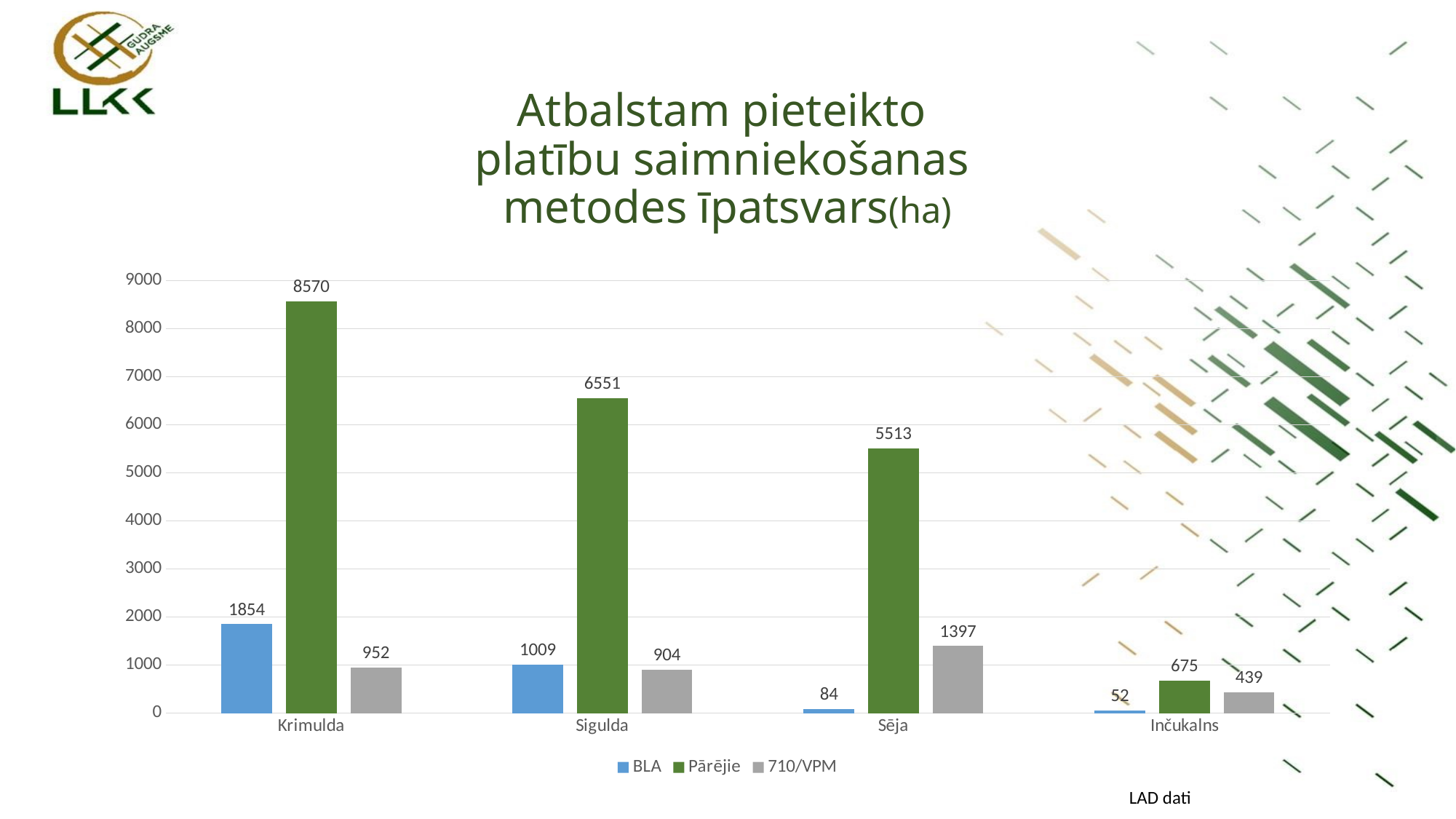
How many series does the legend list? 3 Which is larger: the 710/VPM value for Krimulda or for Sigulda? Krimulda What is the value of 710/VPM for Inčukalns? 439 What is the value of Pārējie for Krimulda? 8570 What is the value of BLA for Sēja? 84 How many categories are shown on the x axis? 4 What is the total of the three values for Inčukalns? 1166 Which category has the highest Pārējie value? Krimulda What kind of chart is shown on the slide? bar chart Is the Pārējie value for Sēja greater or less than 5000? greater What is the difference between the Pārējie values for Sigulda and Sēja? 1038 Which category has the lowest BLA value? Inčukalns